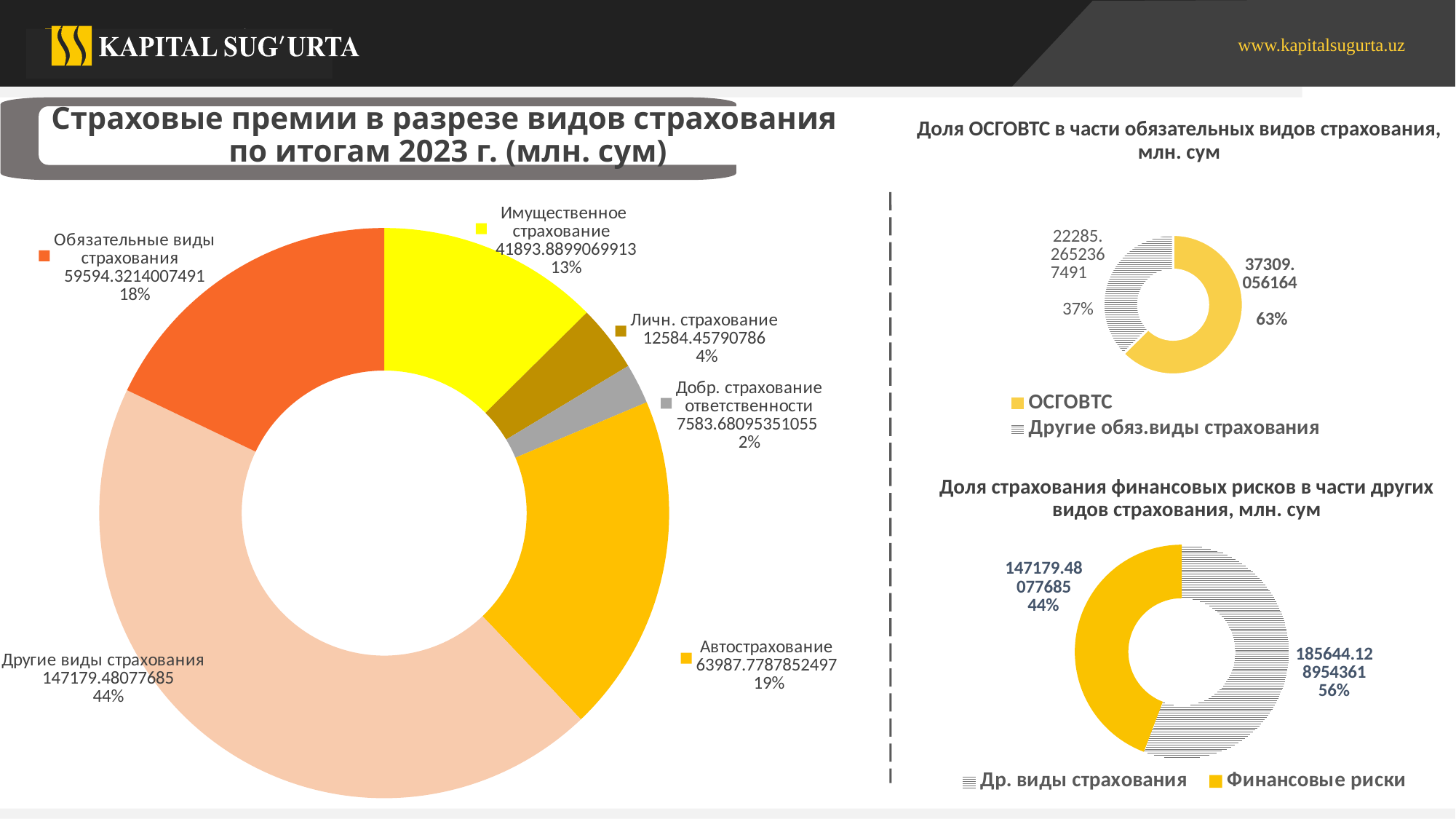
In the chart 'Доля страхования финансовых рисков в части других видов страхования, млн. сум', how many entries does the legend list? 2 In the chart 'Страховые премии в разрезе видов страхования по итогам 2023 г. (млн. сум)', what is the value for Автострахование? 63987.7787852497 What kind of chart is 'Страховые премии в разрезе видов страхования по итогам 2023 г. (млн. сум)'? Doughnut chart In the chart 'Страховые премии в разрезе видов страхования по итогам 2023 г. (млн. сум)', what is the value for Личн. страхование? 12584.45790786 In the chart 'Страховые премии в разрезе видов страхования по итогам 2023 г. (млн. сум)', what percentage share does Имущественное страхование have? 13% In the chart 'Страховые премии в разрезе видов страхования по итогам 2023 г. (млн. сум)', how many categories are shown? 6 In the chart 'Страховые премии в разрезе видов страхования по итогам 2023 г. (млн. сум)', which category has the smallest share? Добр. страхование ответственности In the chart 'Доля страхования финансовых рисков в части других видов страхования, млн. сум', what is the value for Др. виды страхования? 185644.128954361 In the chart 'Доля ОСГОВТС в части обязательных видов страхования, млн. сум', what is the value for ОСГОВТС? 37309.056164 In the chart 'Доля ОСГОВТС в части обязательных видов страхования, млн. сум', what percentage share does Другие обяз.виды страхования have? 37% In the chart 'Страховые премии в разрезе видов страхования по итогам 2023 г. (млн. сум)', which category has the largest share? Другие виды страхования In the chart 'Страховые премии в разрезе видов страхования по итогам 2023 г. (млн. сум)', which is larger: Обязательные виды страхования or Имущественное страхование? Обязательные виды страхования